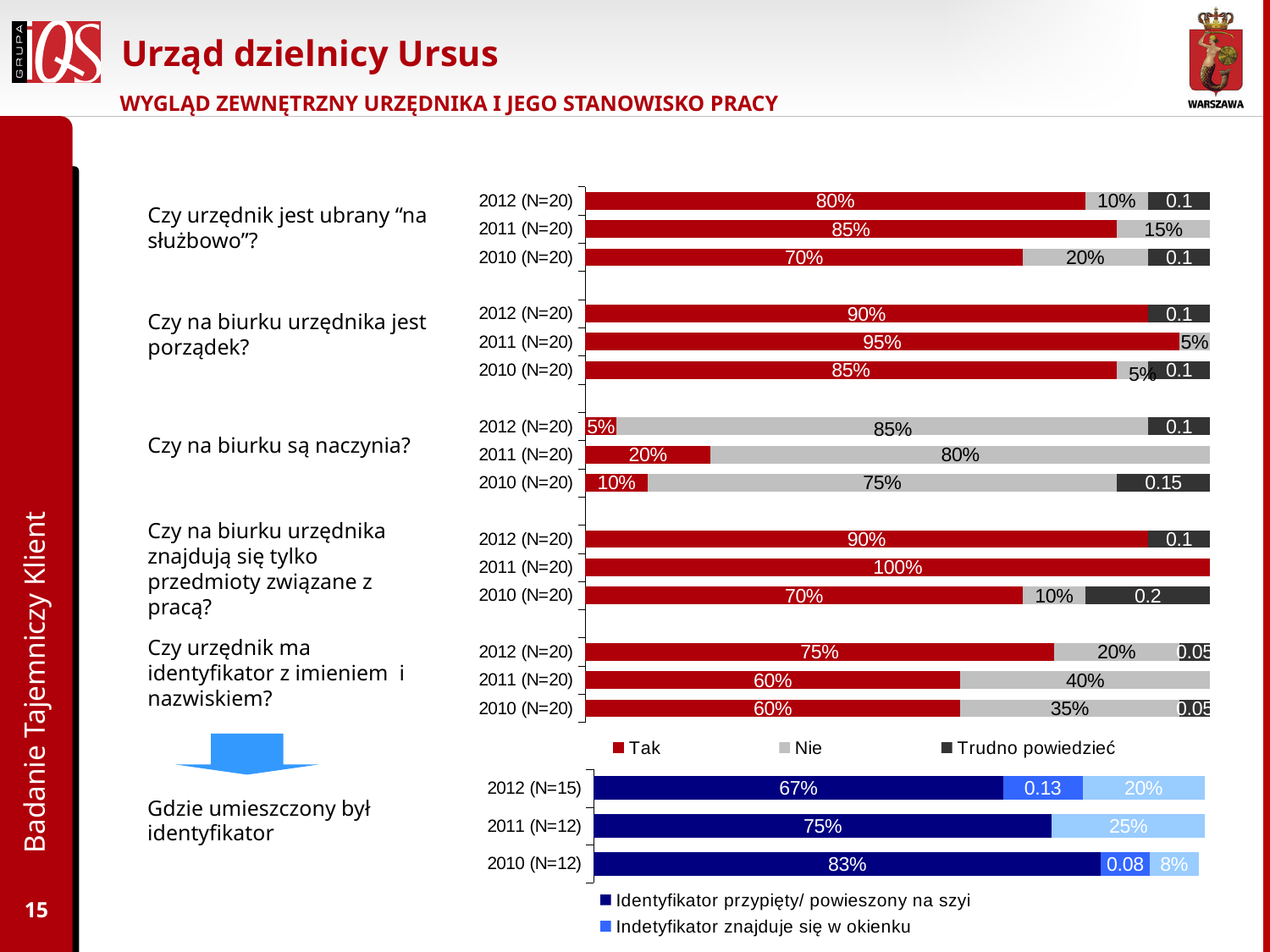
In the upper chart, for "Czy urzędnik ma identyfikator z imieniem i nazwiskiem?", what is the difference between the "Tak" values for 2012 and 2011? 15% What type of chart is used on this slide? Stacked bar chart In the upper chart, what percentage answered "Nie" to "Czy na biurku są naczynia?" in 2011 (N=20)? 80% How many bars (year rows) does the lower chart "Gdzie umieszczony był identyfikator" have? 3 In the upper chart, what is the "Tak" value for "Czy na biurku urzędnika znajdują się tylko przedmioty związane z pracą?" in 2011 (N=20)? 100% In the upper chart, for "Czy urzędnik jest ubrany 'na służbowo'?", is the "Tak" value larger in 2011 or in 2010? 2011 In the lower chart ("Gdzie umieszczony był identyfikator"), what is the value for "Indetyfikator znajduje się w okienku" in 2012 (N=15)? 0.13 In the upper chart, for "Czy na biurku urzędnika jest porządek?", which year has the highest "Tak" share? 2011 (N=20) In the upper chart, what percentage answered "Tak" to "Czy urzędnik jest ubrany 'na służbowo'?" in 2012 (N=20)? 80% How many series does the legend of the upper chart list? 3 In the upper chart, for "Czy na biurku są naczynia?", which year has the lowest "Tak" share? 2012 (N=20) In the lower chart ("Gdzie umieszczony był identyfikator"), what is the value for "Identyfikator przypięty/ powieszony na szyi" in 2010 (N=12)? 83%